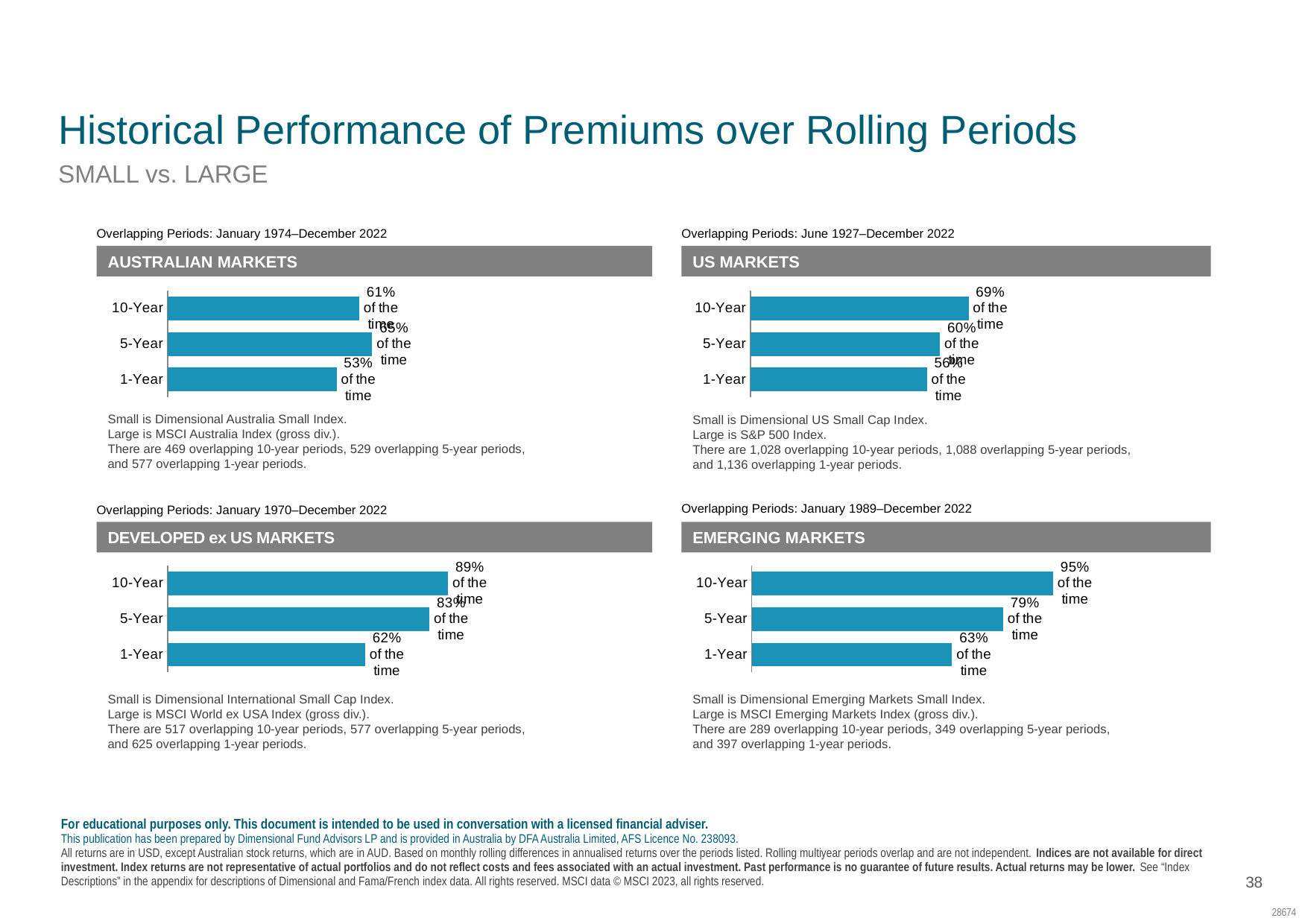
In the Developed ex US Markets chart, do the values rise or fall going from 1-Year to 10-Year? Rise In the Developed ex US Markets chart, what is the value for 5-Year? 83% of the time In the Emerging Markets chart, what is the difference between the 10-Year and 1-Year values? 32% In the Developed ex US Markets chart, which is larger, the 10-Year value or the 1-Year value? 10-Year In the Emerging Markets chart, what is the value for 10-Year? 95% of the time What overlapping period range is shown above the US Markets chart? June 1927–December 2022 What type of chart is used for the Emerging Markets data? Bar chart In the Australian Markets chart, what is the value for 10-Year? 61% of the time In the US Markets chart, what is the value for 1-Year? 56% of the time In the Australian Markets chart, which period has the highest value? 5-Year In the US Markets chart, which period has the lowest value? 1-Year How many bars are shown in the US Markets chart? 3